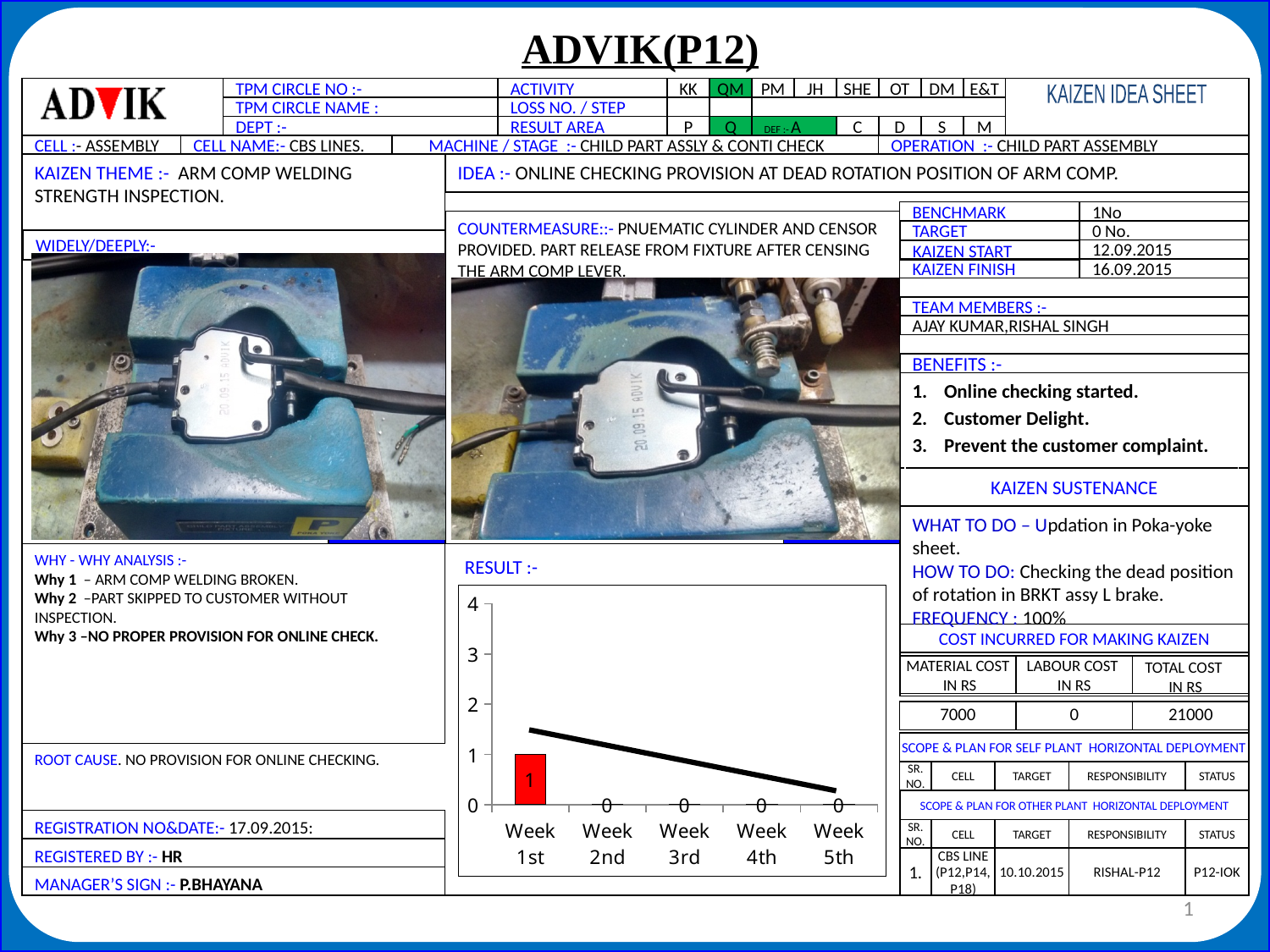
What is the value for Week 3rd in the RESULT chart? 0 Which week has the highest value in the RESULT chart? Week 1st What is the highest value shown on the y axis of the RESULT chart? 4 Which is larger in the RESULT chart, the value for Week 1st or the value for Week 4th? Week 1st What is the value for Week 5th in the RESULT chart? 0 What is the difference between the values for Week 1st and Week 2nd in the RESULT chart? 1 What kind of chart is shown under RESULT? bar chart What colour is the bar for Week 1st in the RESULT chart? red How many weeks are shown on the x axis of the RESULT chart? 5 Is the value for Week 1st in the RESULT chart greater or less than 2? less What is the value for Week 1st in the RESULT chart? 1 Do the values in the RESULT chart rise or fall from Week 1st to Week 5th? fall